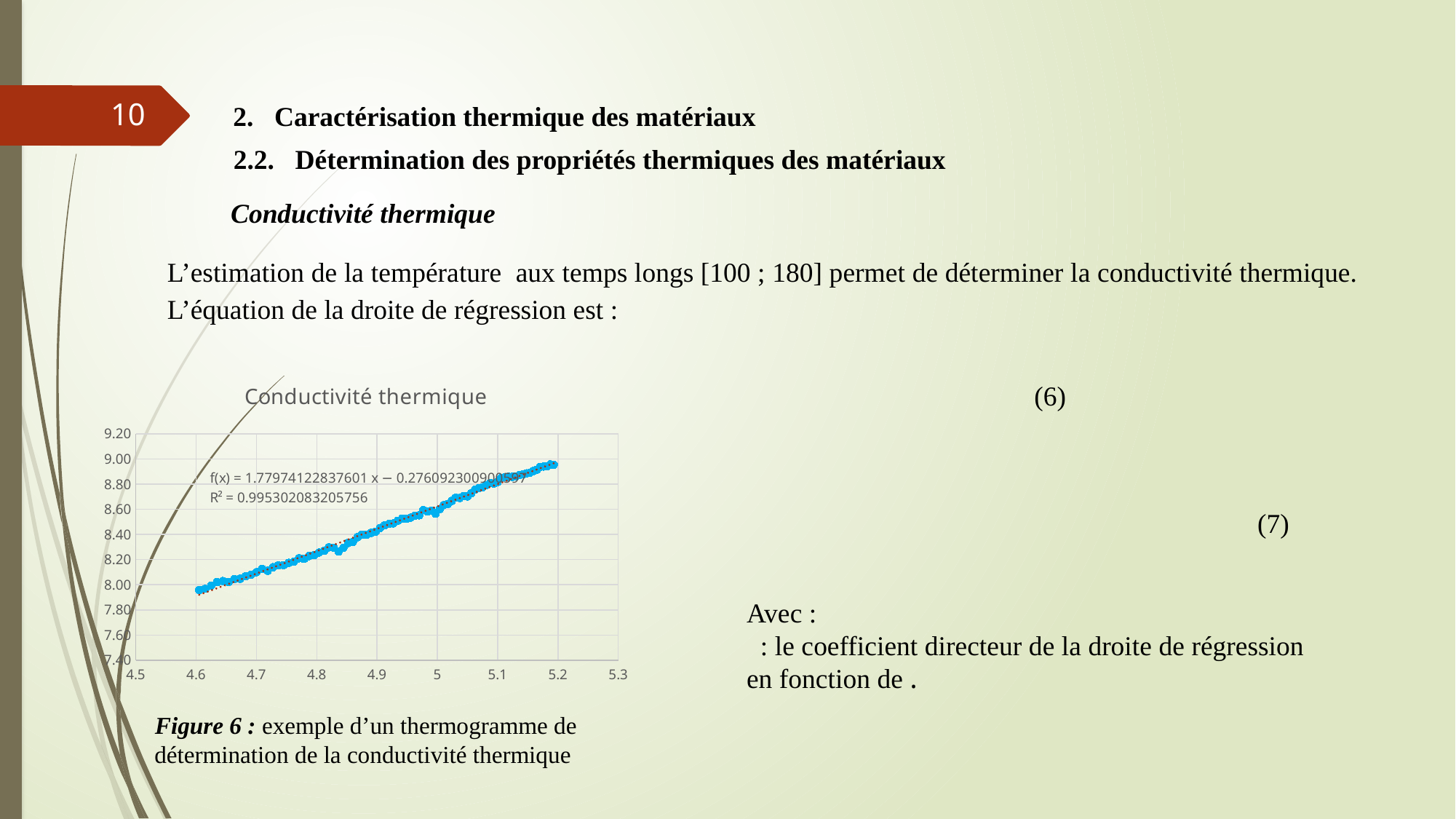
Is the plotted value at x = 4.6 greater or less than 8.20? less What is the title of the chart? Conductivité thermique What is the slope (coefficient of x) in the trendline equation printed on the chart? 1.77974122837601 Which is larger, the plotted value at x = 5.2 or at x = 4.6? x = 5.2 Is the plotted value at x = 5.0 greater or less than 8.40? greater What is the intercept in the trendline equation printed on the chart? −0.276092300900597 Do the plotted values rise or fall as x increases from 4.6 to 5.2? rise Is the plotted value at x = 5.1 greater or less than 8.60? greater What is the R² value printed on the chart? 0.995302083205756 What kind of chart is shown on the slide? scatter chart What colour are the data points in the chart? blue